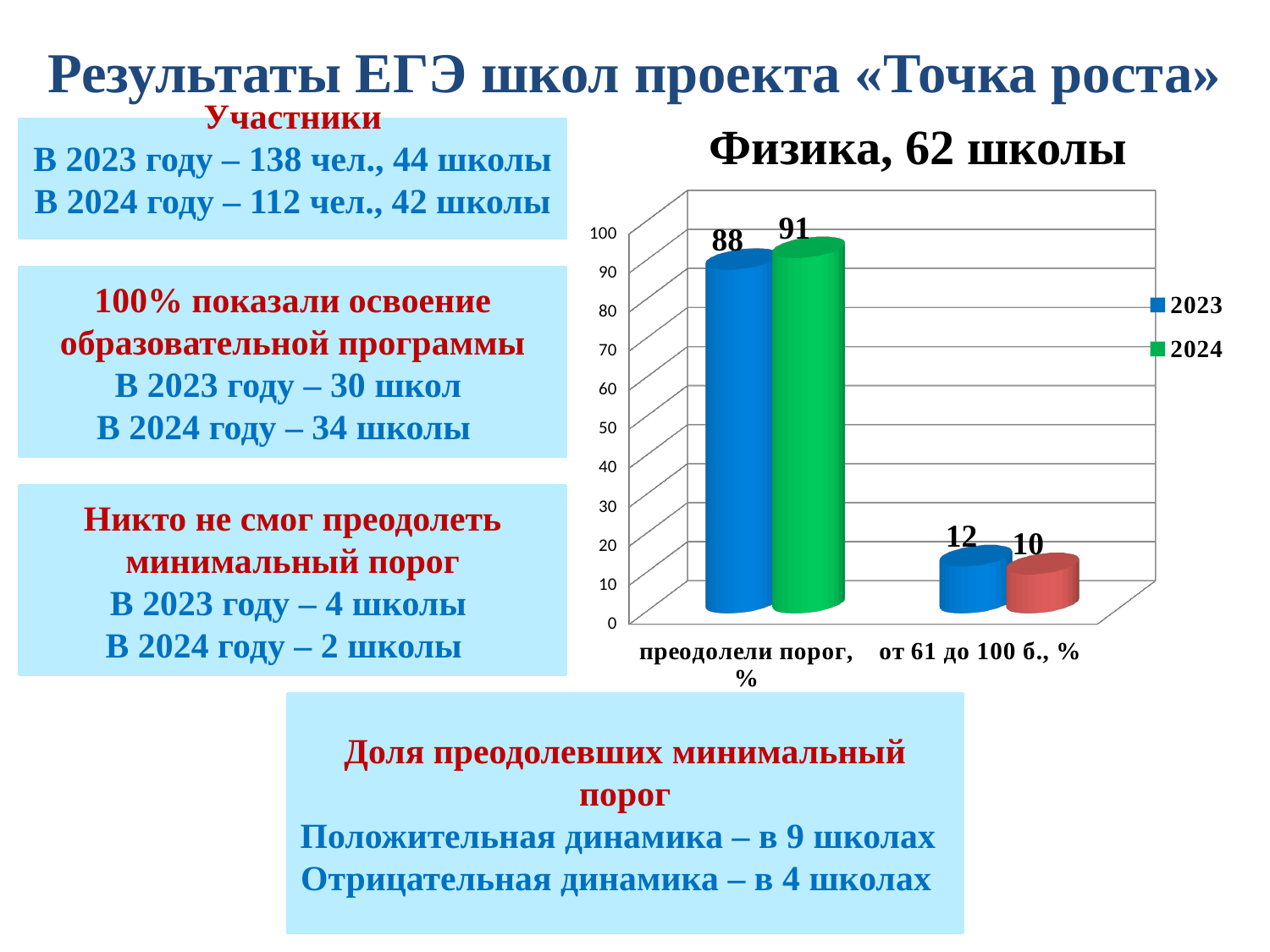
What is the value for 2023 in the category "преодолели порог, %"? 88 What is the difference between the 2023 and 2024 values in the category "от 61 до 100 б., %"? 2 How many series does the legend list? 2 What is the value for 2024 in the category "преодолели порог, %"? 91 What is the value for 2023 in the category "от 61 до 100 б., %"? 12 What is the value for 2024 in the category "от 61 до 100 б., %"? 10 What is the title of the chart? Физика, 62 школы What is the difference between the 2024 and 2023 values in the category "преодолели порог, %"? 3 Which series has the higher value in the category "от 61 до 100 б., %", 2023 or 2024? 2023 What kind of chart is shown on the slide? Bar chart Which category has the lowest value for 2024? от 61 до 100 б., % Which series has the higher value in the category "преодолели порог, %", 2023 or 2024? 2024